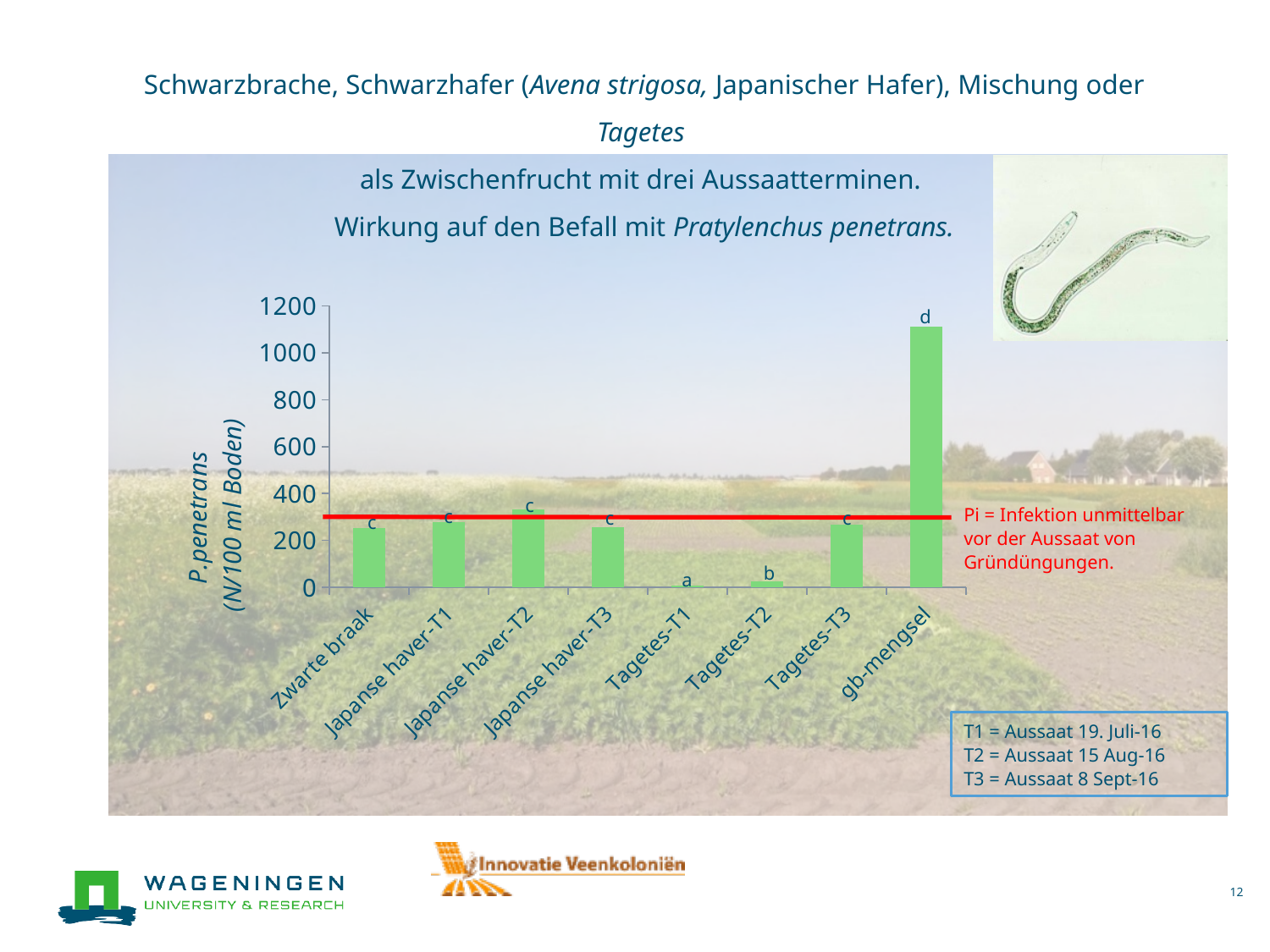
Is the value for Tagetes-T2 greater or less than 200? less What is the label of the y axis of the chart? P.penetrans (N/100 ml Boden) Is the value for Zwarte braak greater or less than 400? less What kind of chart is shown on the slide? bar chart Which is larger, the value for gb-mengsel or the value for Zwarte braak? gb-mengsel How many categories are shown on the x axis of the chart? 8 Which is larger, the value for Tagetes-T3 or the value for Tagetes-T1? Tagetes-T3 Is the value for Japanse haver-T2 greater or less than 200? greater Which category has the lowest P. penetrans value? Tagetes-T1 Which category has the highest P. penetrans value? gb-mengsel What letter is printed above the gb-mengsel bar? d